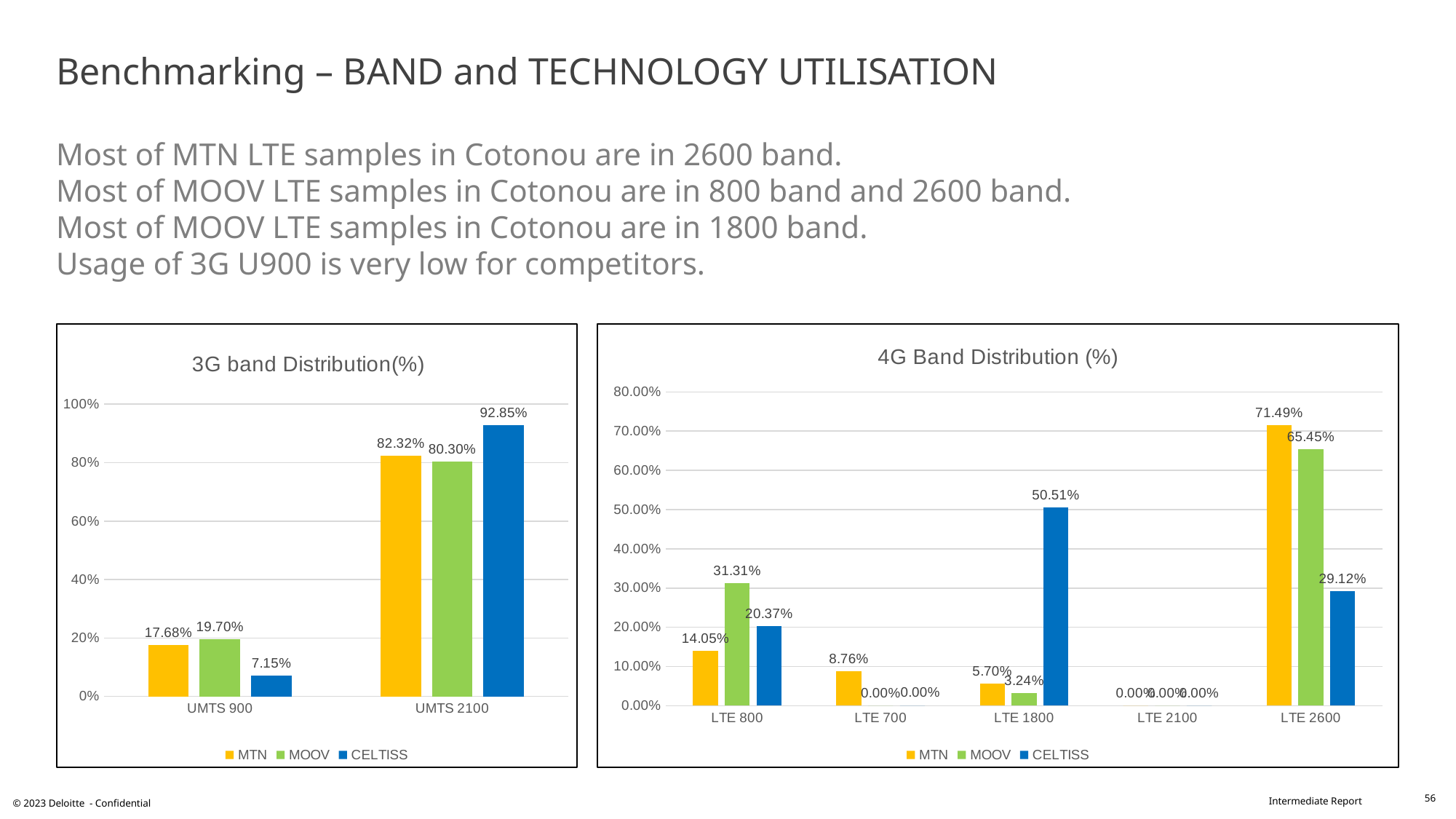
In the 4G Band Distribution (%) chart, what is the difference between the MTN and CELTISS values at LTE 2600? 42.37% In the 3G band Distribution(%) chart, which series has the lowest value at UMTS 900? CELTISS In the 4G Band Distribution (%) chart, is the MTN value at LTE 2600 larger or smaller than the MOOV value at LTE 2600? larger What type of chart is the 4G Band Distribution (%) chart? bar chart How many band categories are shown on the x axis of the 4G Band Distribution (%) chart? 5 How many series does the legend of the 3G band Distribution(%) chart list? 3 In the 4G Band Distribution (%) chart, what is the value for CELTISS at LTE 1800? 50.51% In the 3G band Distribution(%) chart, what is the value for MTN at UMTS 900? 17.68% In the 4G Band Distribution (%) chart, what is the value for MOOV at LTE 800? 31.31% In the 3G band Distribution(%) chart, what is the value for CELTISS at UMTS 2100? 92.85% In the 4G Band Distribution (%) chart, which series has the highest value at LTE 2600? MTN In the 3G band Distribution(%) chart, what is the difference between the MOOV values at UMTS 2100 and UMTS 900? 60.60%